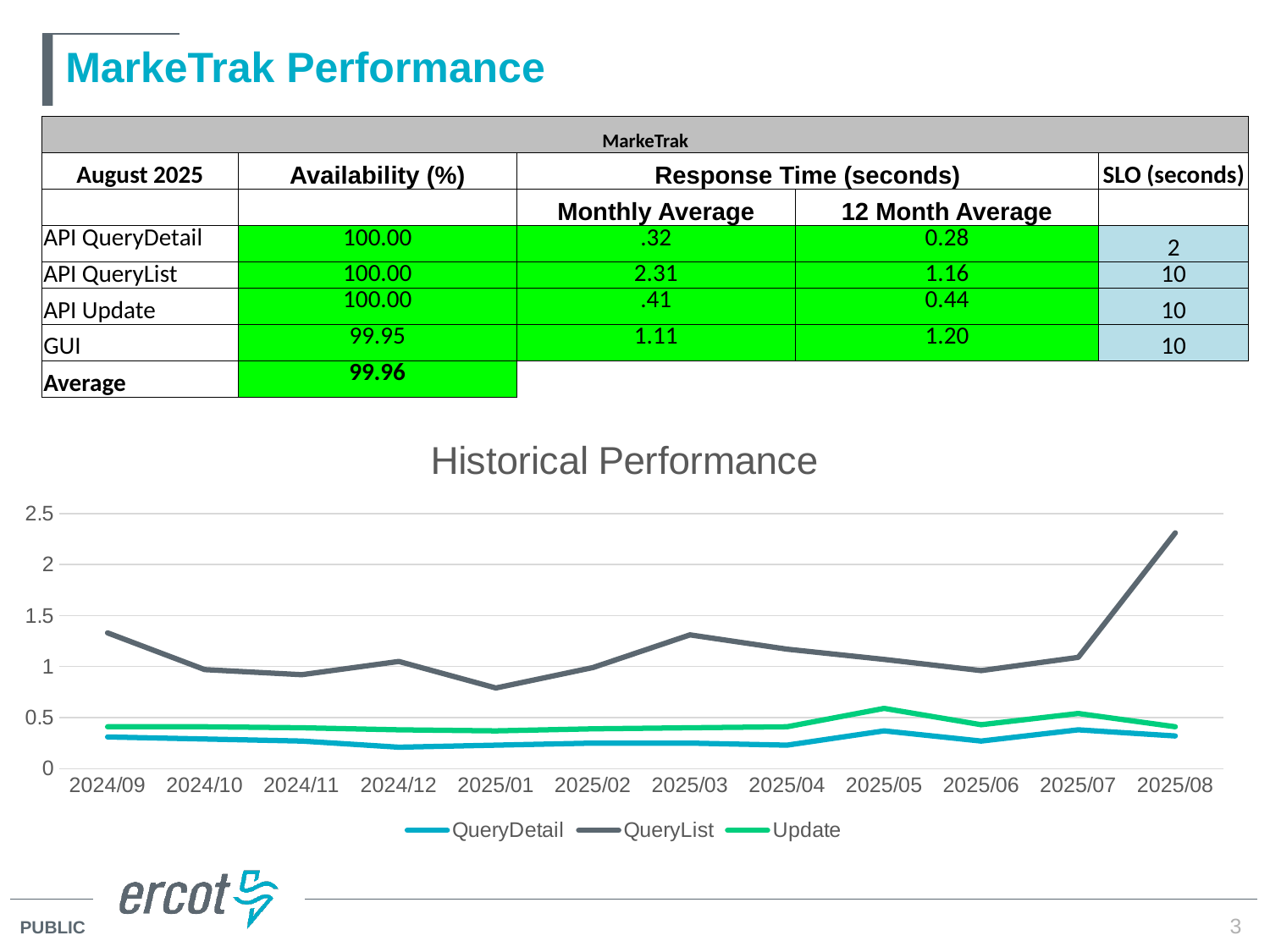
At 2025/05, which series has the larger value, Update or QueryDetail? Update How many series does the legend of the Historical Performance chart list? 3 Is the QueryList value for 2025/08 greater or less than 2? greater In which month does the QueryList series reach its highest value? 2025/08 Is the QueryList value for 2025/01 greater or less than 1? less Is the QueryDetail value for 2024/12 greater or less than 0.5? less Does the QueryList series rise or fall from 2025/07 to 2025/08? rise In which month does the QueryList series reach its lowest value? 2025/01 What kind of chart is shown under the title "Historical Performance"? line chart Which series has the highest value at 2025/08 in the Historical Performance chart? QueryList How many months are plotted along the x axis of the Historical Performance chart? 12 What are the three series names listed in the legend of the Historical Performance chart? QueryDetail, QueryList, Update